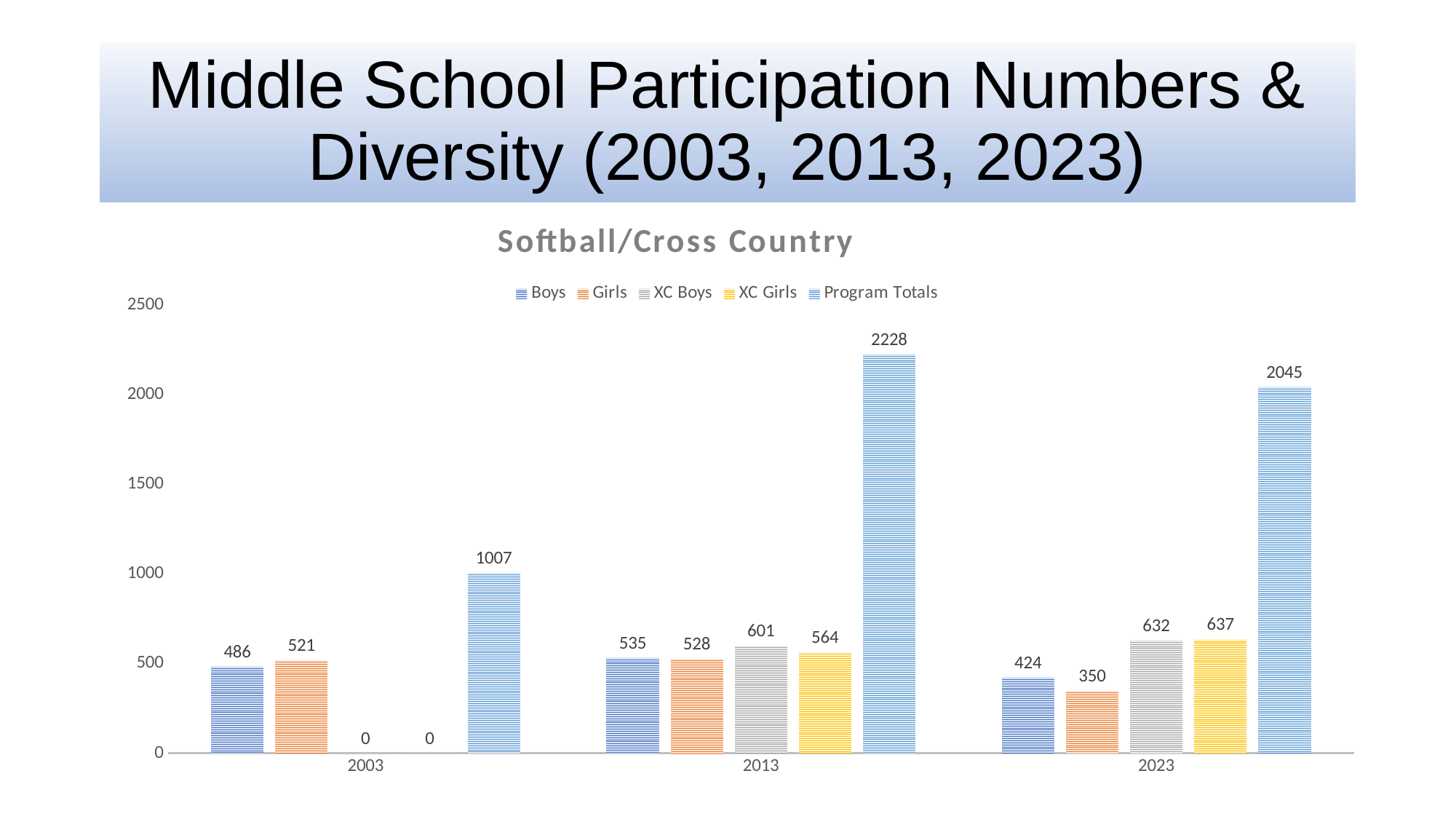
What kind of chart is this? Bar chart What is the value for Boys in 2003? 486 Which is larger in 2013, Boys or Girls? Boys What is the value for XC Boys in 2003? 0 How many year categories are shown on the x axis? 3 In which year is the Program Totals value highest? 2013 In which year is the Girls value lowest? 2023 How many series does the legend list? 5 What is the value for XC Girls in 2023? 637 What is the difference between the Program Totals values for 2013 and 2023? 183 What is the value for Program Totals in 2013? 2228 What is the title of the chart? Softball/Cross Country